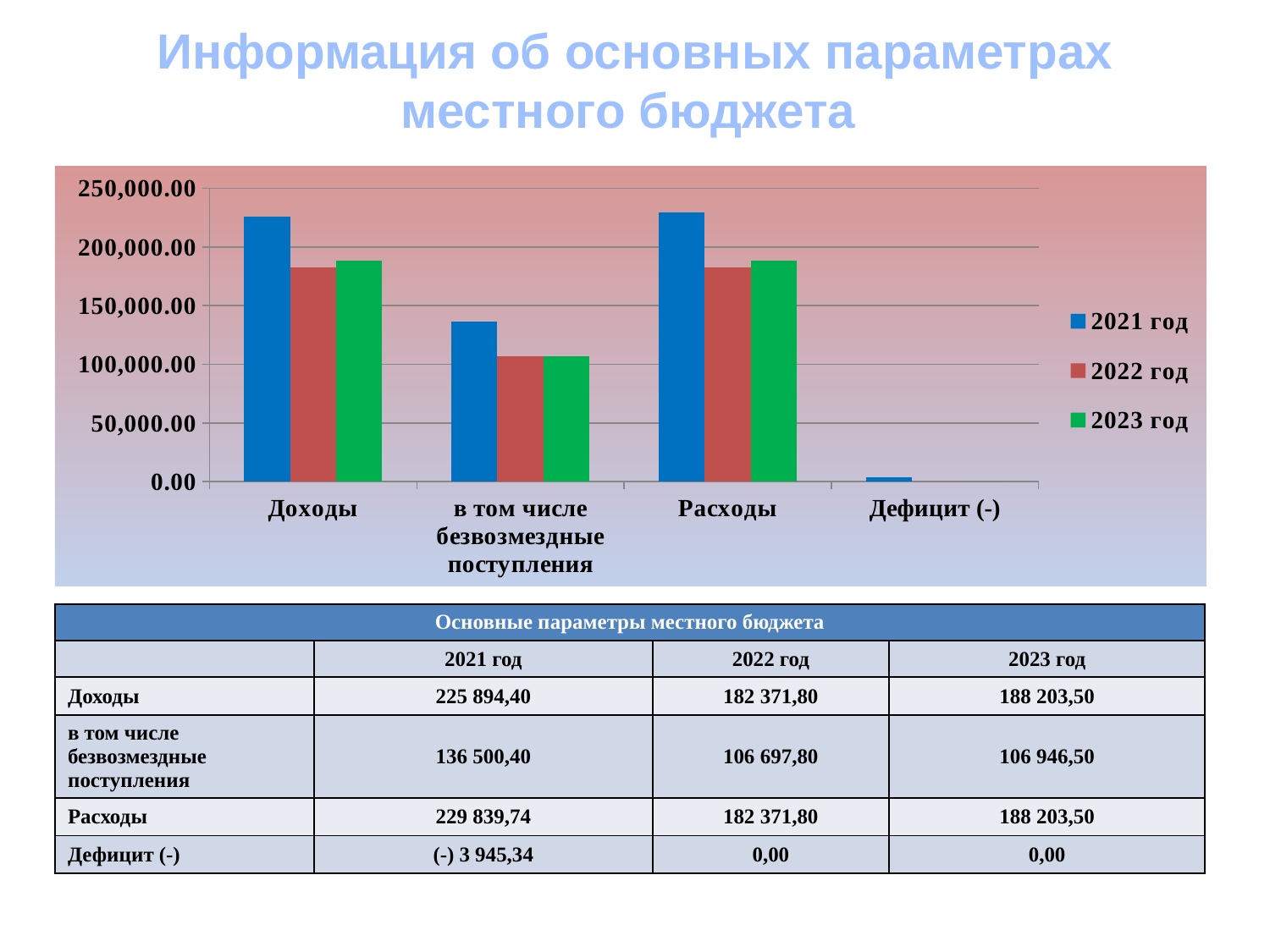
What kind of chart is shown on the slide? bar chart What is the value of Доходы for 2021 год? 225 894,40 Is the value of Доходы for 2021 год greater or less than 200,000.00? greater How many categories are shown on the x axis of the chart? 4 How many series does the chart legend list? 3 Which is larger: Доходы for 2022 год or Доходы for 2023 год? 2023 год What colour represents 2023 год in the chart? green Which year has the highest value for Расходы? 2021 год What is the value of в том числе безвозмездные поступления for 2022 год? 106 697,80 Is the value of в том числе безвозмездные поступления for 2023 год greater or less than 150,000.00? less Which category has the lowest values across all three years? Дефицит (-) What is the value of Расходы for 2023 год? 188 203,50